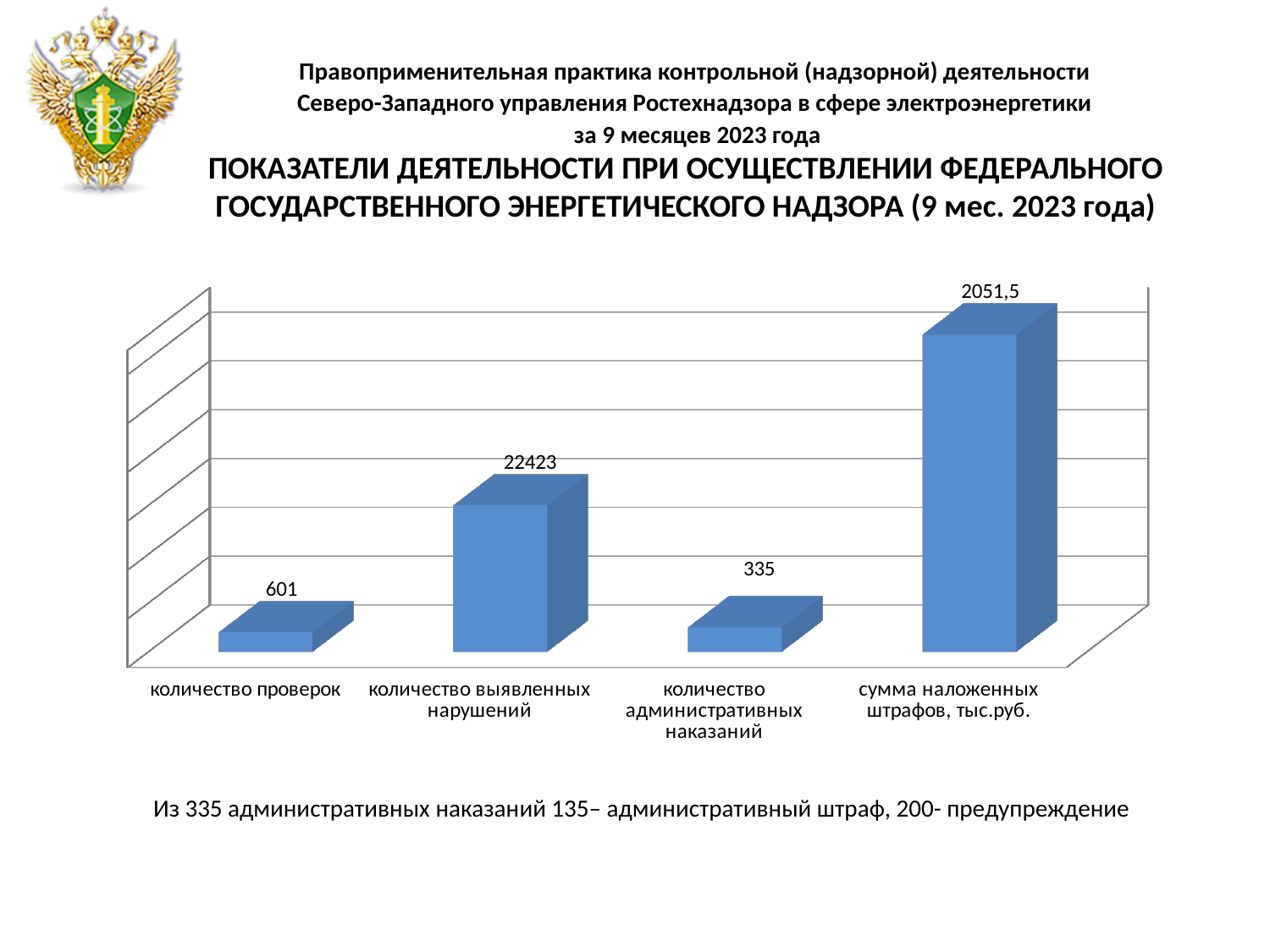
What is the value for "сумма наложенных штрафов, тыс.руб."? 2051,5 What is the value for "количество административных наказаний"? 335 What is the value for "количество выявленных нарушений"? 22423 What is the difference between the value for "количество проверок" and the value for "количество административных наказаний"? 266 Which category is shown first on the x axis? количество проверок What is the difference between the value for "количество выявленных нарушений" and the value for "количество проверок"? 21822 What kind of chart is shown on the slide? bar chart What colour are the bars in the chart? blue What is the value for "количество проверок"? 601 How many categories are shown in the chart? 4